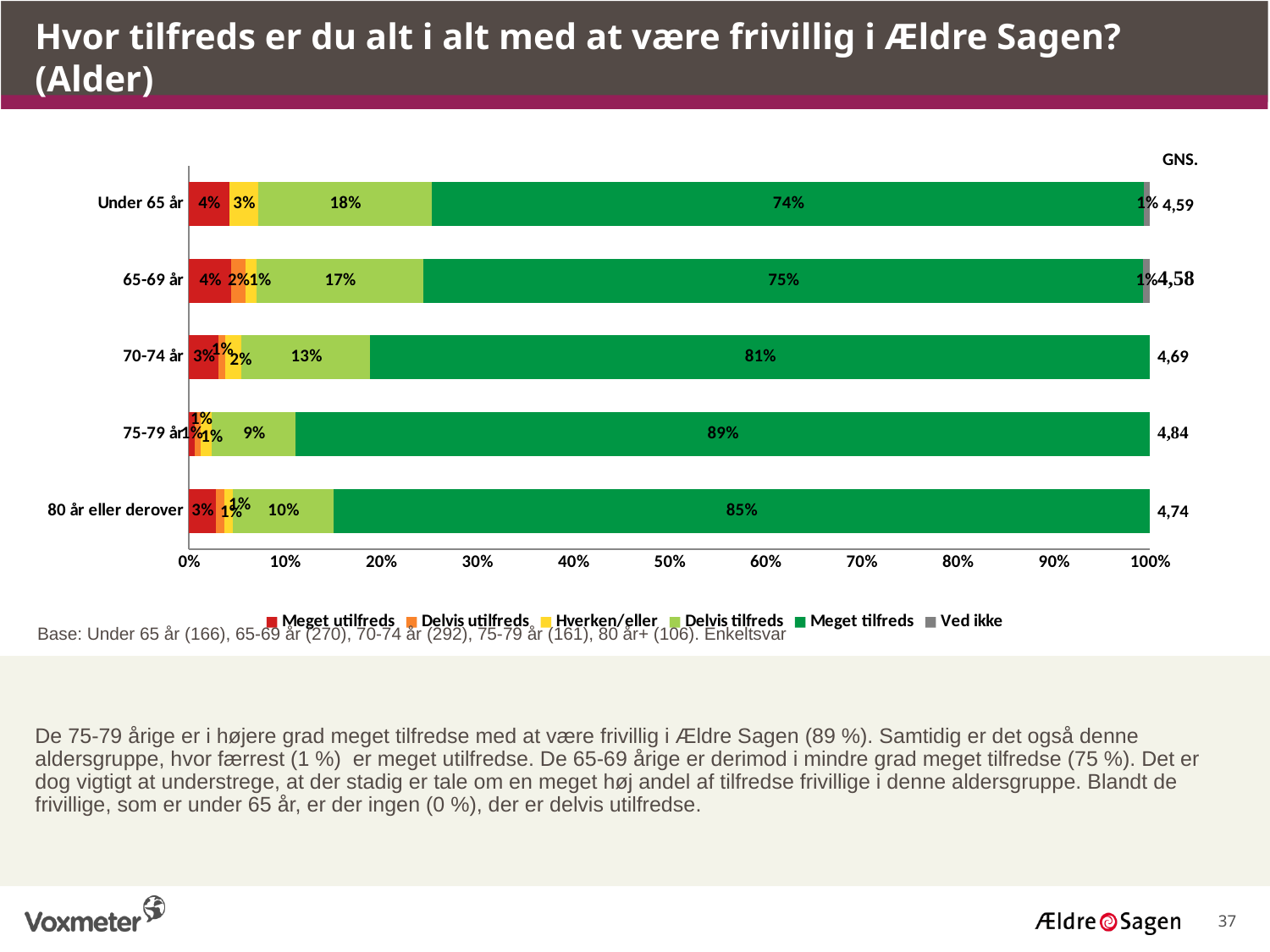
Which age group has the highest 'Meget tilfreds' share? 75-79 år What is the difference between the 'Meget tilfreds' values for 75-79 år and 65-69 år? 14 percentage points How many age categories are shown on the chart? 5 What is the GNS. value shown for 70-74 år? 4,69 Is the 'Meget tilfreds' value for 70-74 år greater or less than 80%? greater Which age group has the lowest 'Meget tilfreds' share? Under 65 år What kind of chart is shown on the slide? Stacked bar chart Which colour represents 'Meget tilfreds' in the legend? Dark green What is the 'Meget tilfreds' value for 75-79 år? 89% What is the 'Delvis tilfreds' value for Under 65 år? 18% Which is larger, the 'Delvis tilfreds' value for 65-69 år or for 80 år eller derover? 65-69 år How many series does the legend list? 6